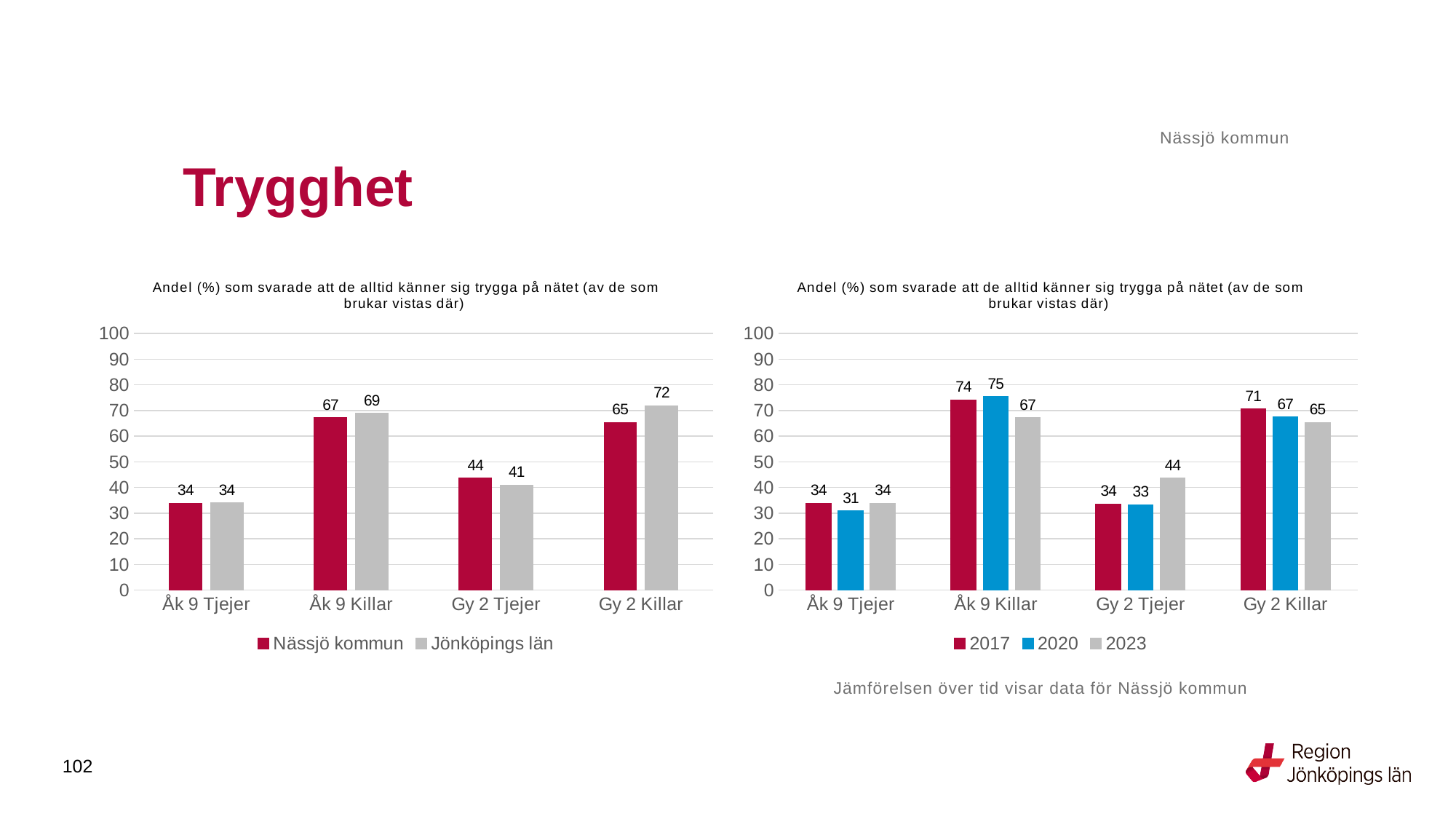
In the left chart, how many series does the legend list? 2 What kind of chart is the right chart? Bar chart In the right chart, how many categories are shown on the x axis? 4 In the right chart, what is the value for 2020 for Åk 9 Tjejer? 31 In the right chart, what is the difference between the 2023 and 2020 values for Gy 2 Tjejer? 11 In the left chart, what is the difference between Jönköpings län and Nässjö kommun for Gy 2 Killar? 7 In the right chart, what is the value for 2023 for Gy 2 Tjejer? 44 In the left chart, what is the value for Jönköpings län for Gy 2 Killar? 72 In the left chart, which category has the lowest value for Nässjö kommun? Åk 9 Tjejer In the right chart, which is larger for Gy 2 Killar: the 2017 value or the 2023 value? 2017 In the right chart, which category has the highest value for 2017? Åk 9 Killar In the left chart, what is the value for Nässjö kommun for Gy 2 Tjejer? 44